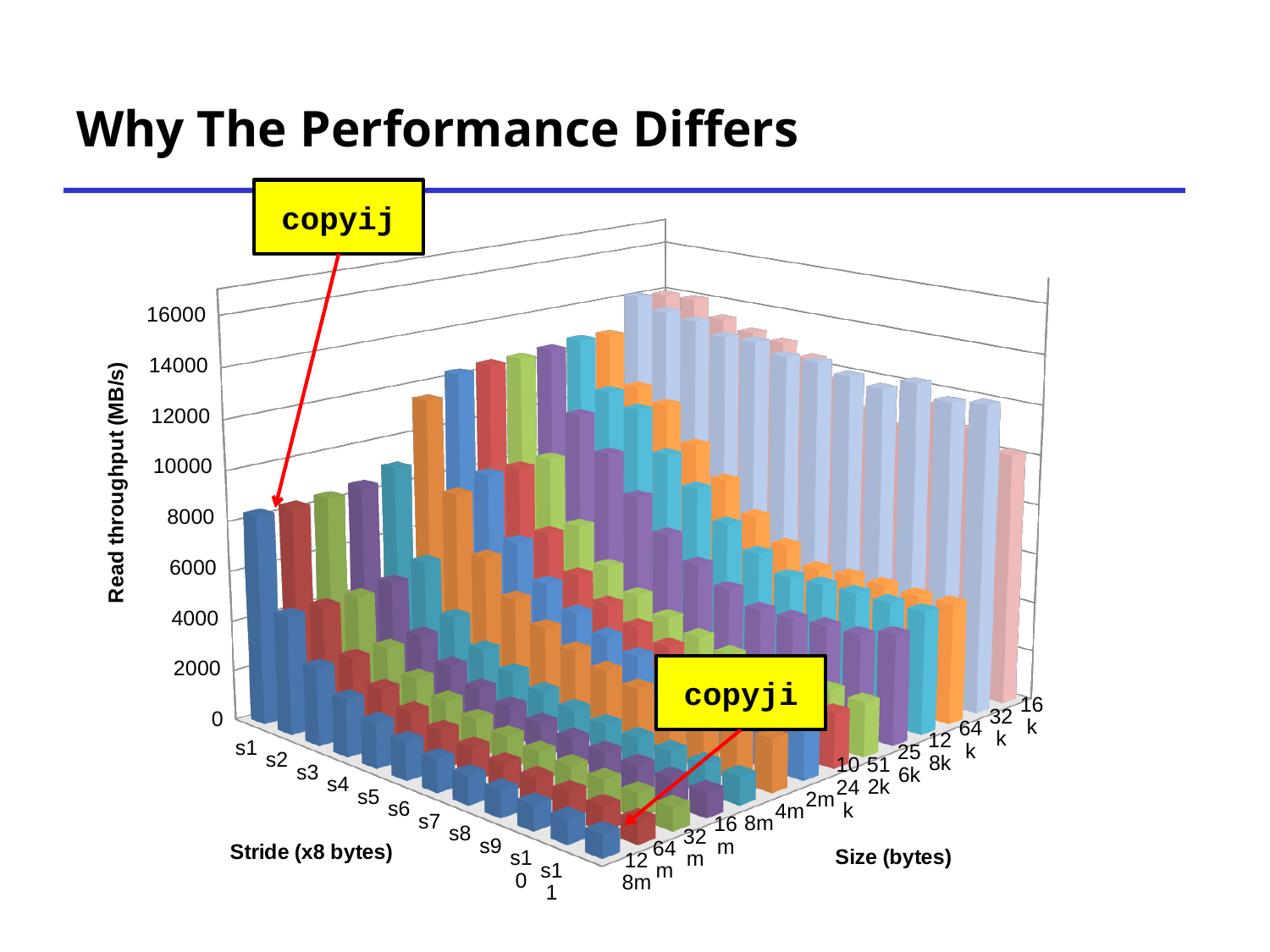
How many size categories are shown along the Size (bytes) axis? 14 Which is larger: the read throughput for copyij (s1, 128m) or for copyji (s11, 128m)? copyij What is the title of the slide containing the chart? Why The Performance Differs What is the label of the vertical axis of the chart? Read throughput (MB/s) What kind of chart is shown on the slide? 3D bar chart Which annotation label points to the bar at stride s1 and size 128m? copyij How many stride categories (s1 through s11) are shown along the Stride axis? 11 For a fixed size, does read throughput generally rise or fall as the stride increases from s1 to s11? fall